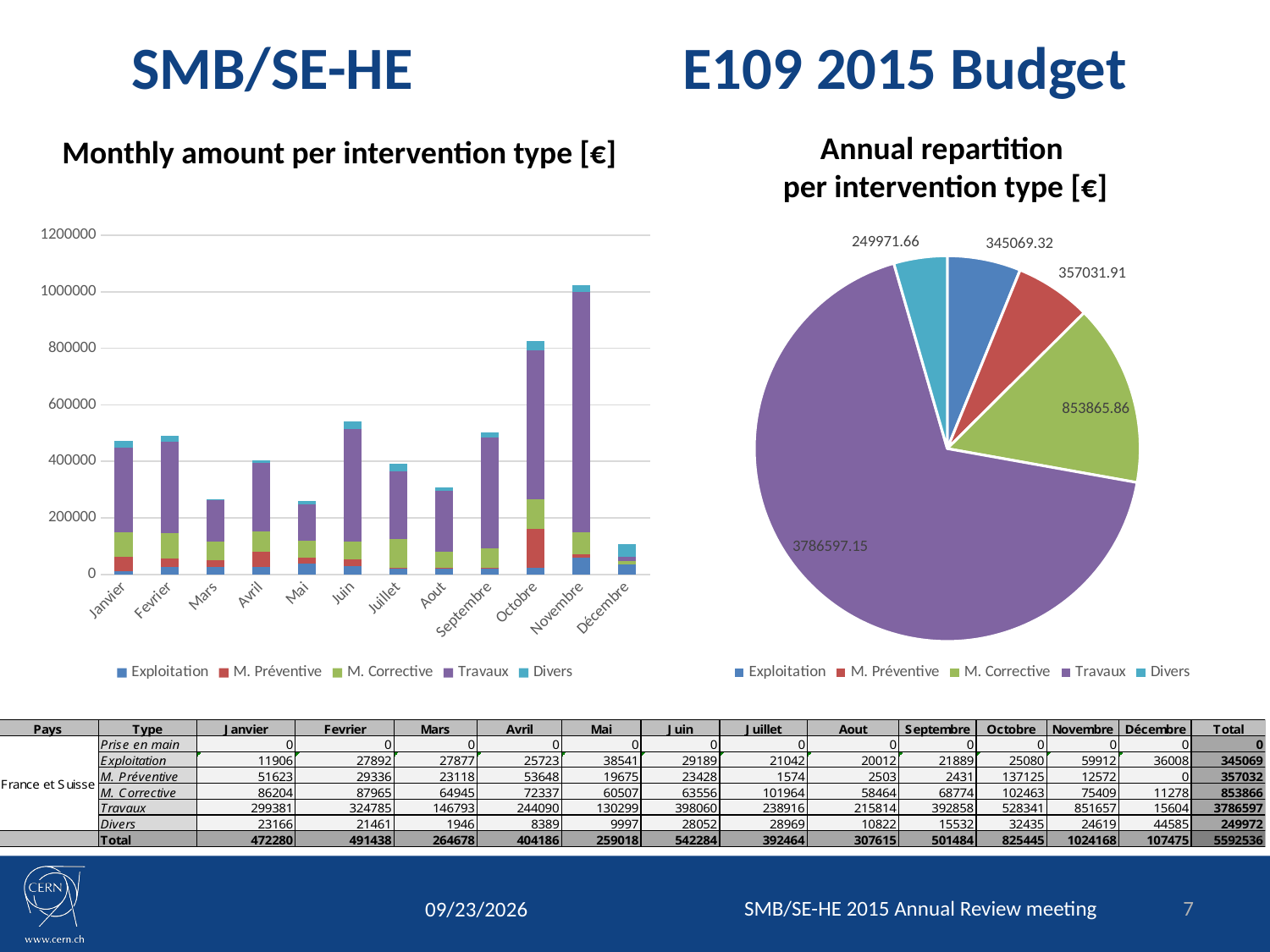
On the 'Monthly amount per intervention type' bar chart, which month has the tallest stacked bar? Novembre On the 'Annual repartition per intervention type' pie chart, what is the value for Travaux? 3786597.15 How many series does the legend of the 'Monthly amount per intervention type' bar chart list? 5 On the 'Monthly amount per intervention type' bar chart, which month has the shortest stacked bar? Décembre On the 'Monthly amount per intervention type' bar chart, is the total for Mars greater or less than 400000? less How many months are shown on the x axis of the 'Monthly amount per intervention type' bar chart? 12 On the 'Annual repartition per intervention type' pie chart, what is the value for M. Corrective? 853865.86 On the 'Annual repartition per intervention type' pie chart, which intervention type has the largest slice? Travaux On the 'Monthly amount per intervention type' bar chart, is the total for Juin greater or less than 400000? greater On the 'Annual repartition per intervention type' pie chart, what is the value for Divers? 249971.66 On the 'Annual repartition per intervention type' pie chart, what is the difference between the M. Corrective value and the M. Préventive value? 496833.95 On the 'Annual repartition per intervention type' pie chart, which intervention type has the smallest slice? Divers